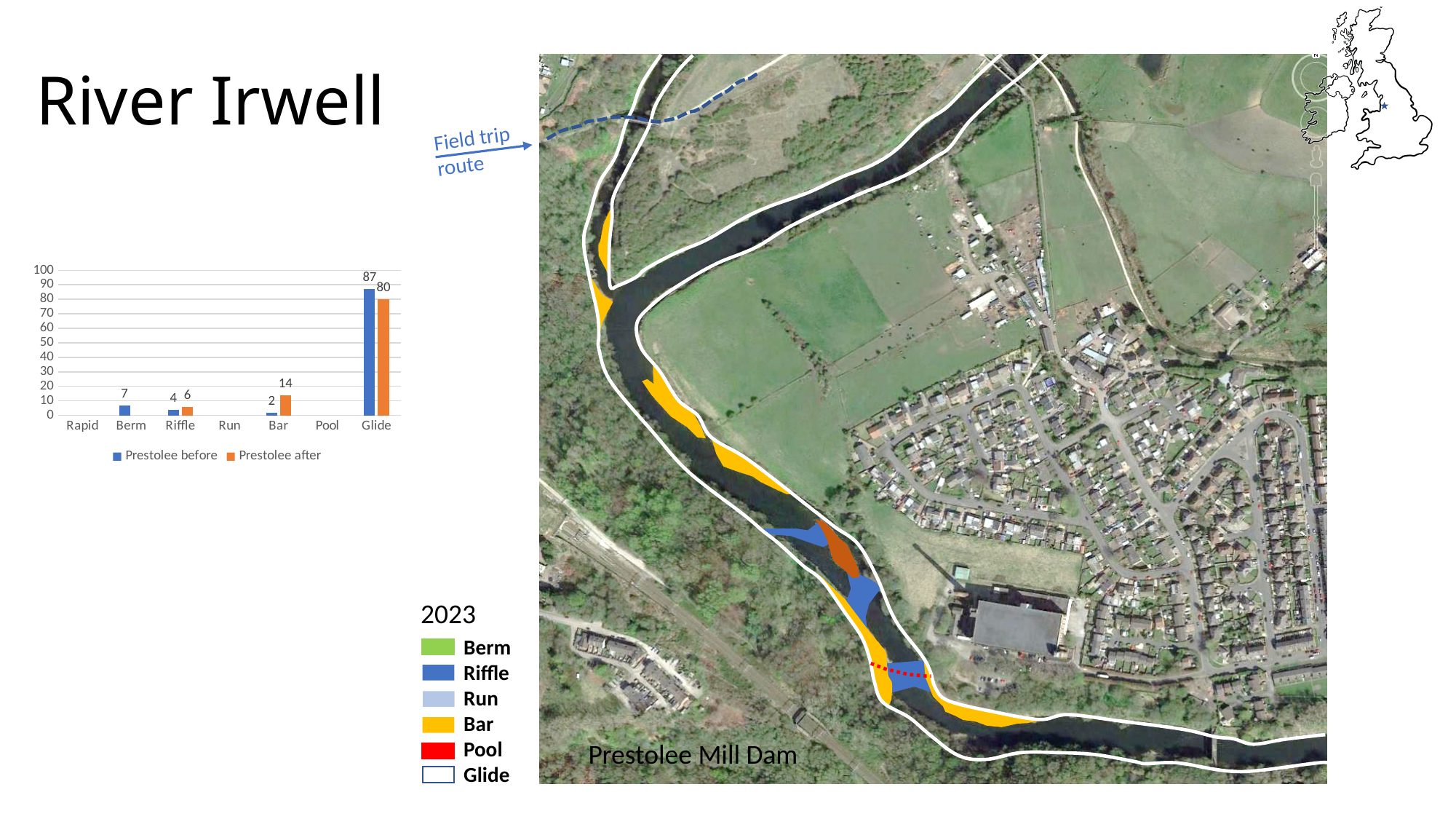
How many categories are shown on the x axis of the chart? 7 What kind of chart is shown on the slide? bar chart What is the value for Bar in the Prestolee after series? 14 What is the value for Glide in the Prestolee before series? 87 Which category has the highest value in the Prestolee before series? Glide Is the value for Glide in the Prestolee after series greater or less than 50? greater Which is larger for Riffle: the Prestolee before value or the Prestolee after value? Prestolee after What is the value for Berm in the Prestolee before series? 7 How many series does the chart legend list? 2 What is the difference between the Prestolee before and Prestolee after values for Bar? 12 What is the value for Glide in the Prestolee after series? 80 What are the two series names listed in the chart legend? Prestolee before, Prestolee after